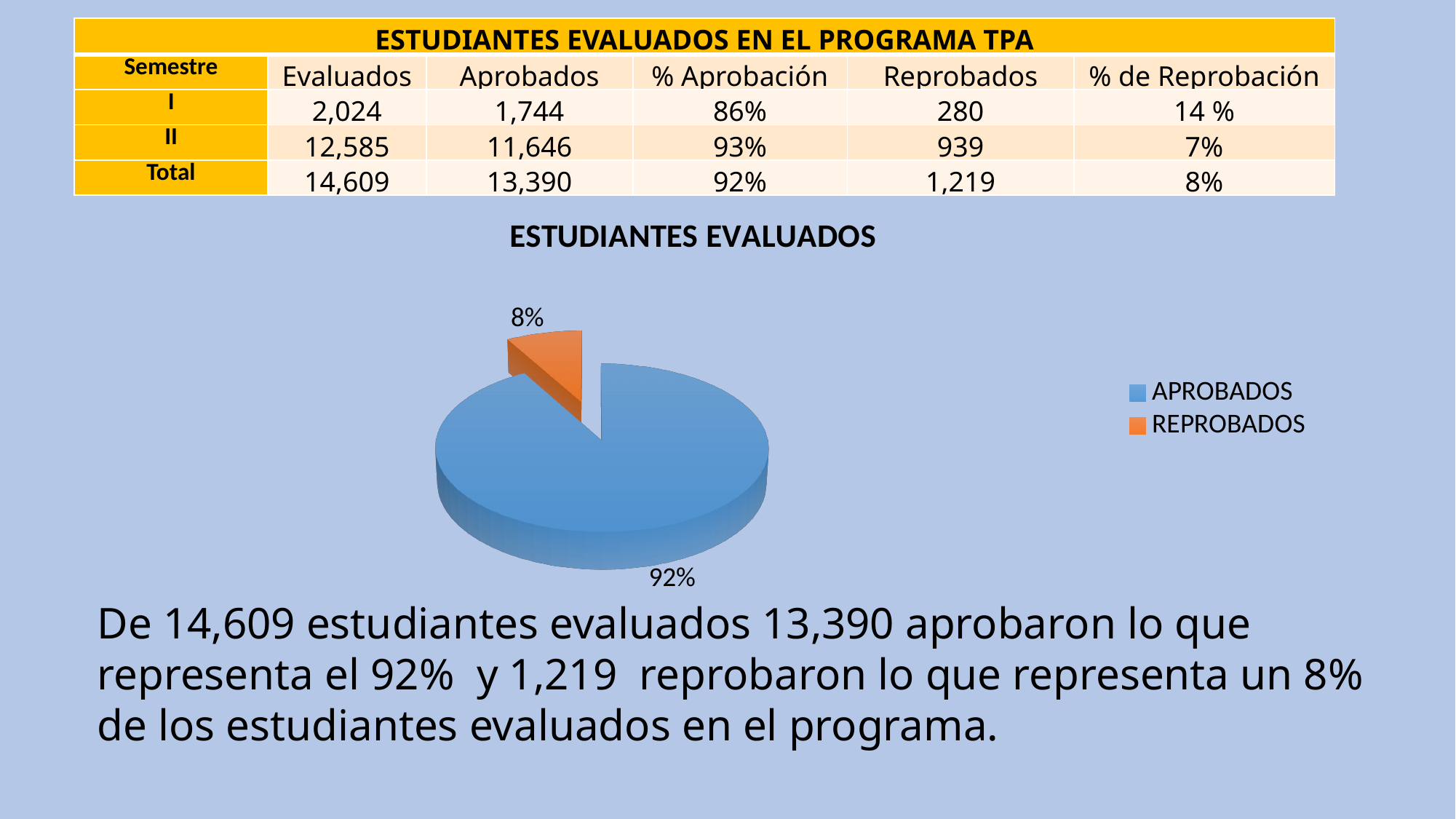
What share of the pie does APROBADOS represent? 92% How many entries does the legend of the pie chart list? 2 What share of the pie does REPROBADOS represent? 8% Which slice of the pie chart is the largest? APROBADOS Which slice of the pie chart is the smallest? REPROBADOS How many slices does the pie chart have? 2 Which is larger in the pie chart, APROBADOS or REPROBADOS? APROBADOS What is the difference in percentage points between the APROBADOS and REPROBADOS slices? 84 Which colour is used for the REPROBADOS slice in the pie chart? orange What kind of chart is shown under the title ESTUDIANTES EVALUADOS? pie chart What is the title of the pie chart? ESTUDIANTES EVALUADOS